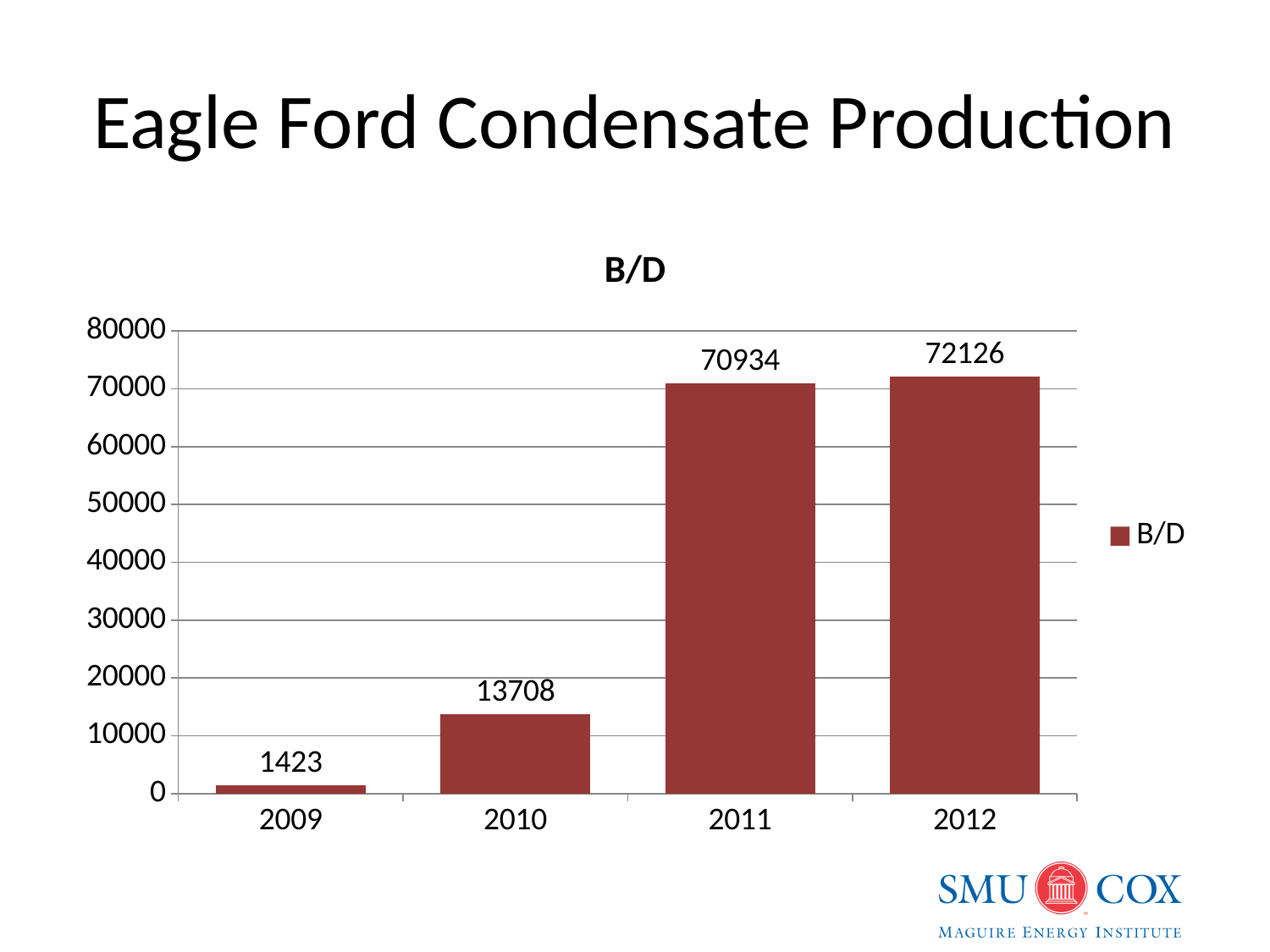
Is the B/D value for 2010 greater or less than 20000? less What is the B/D value for 2011? 70934 How many years are shown on the x axis? 4 What kind of chart is shown on the slide? bar chart Which year has the highest B/D value? 2012 Which is larger, the B/D value for 2010 or for 2011? 2011 Do the B/D values rise or fall from 2009 to 2012? rise What is the B/D value for 2012? 72126 What is the difference between the B/D values for 2012 and 2011? 1192 Which year has the lowest B/D value? 2009 What is the difference between the B/D values for 2011 and 2010? 57226 What is the B/D value for 2009? 1423